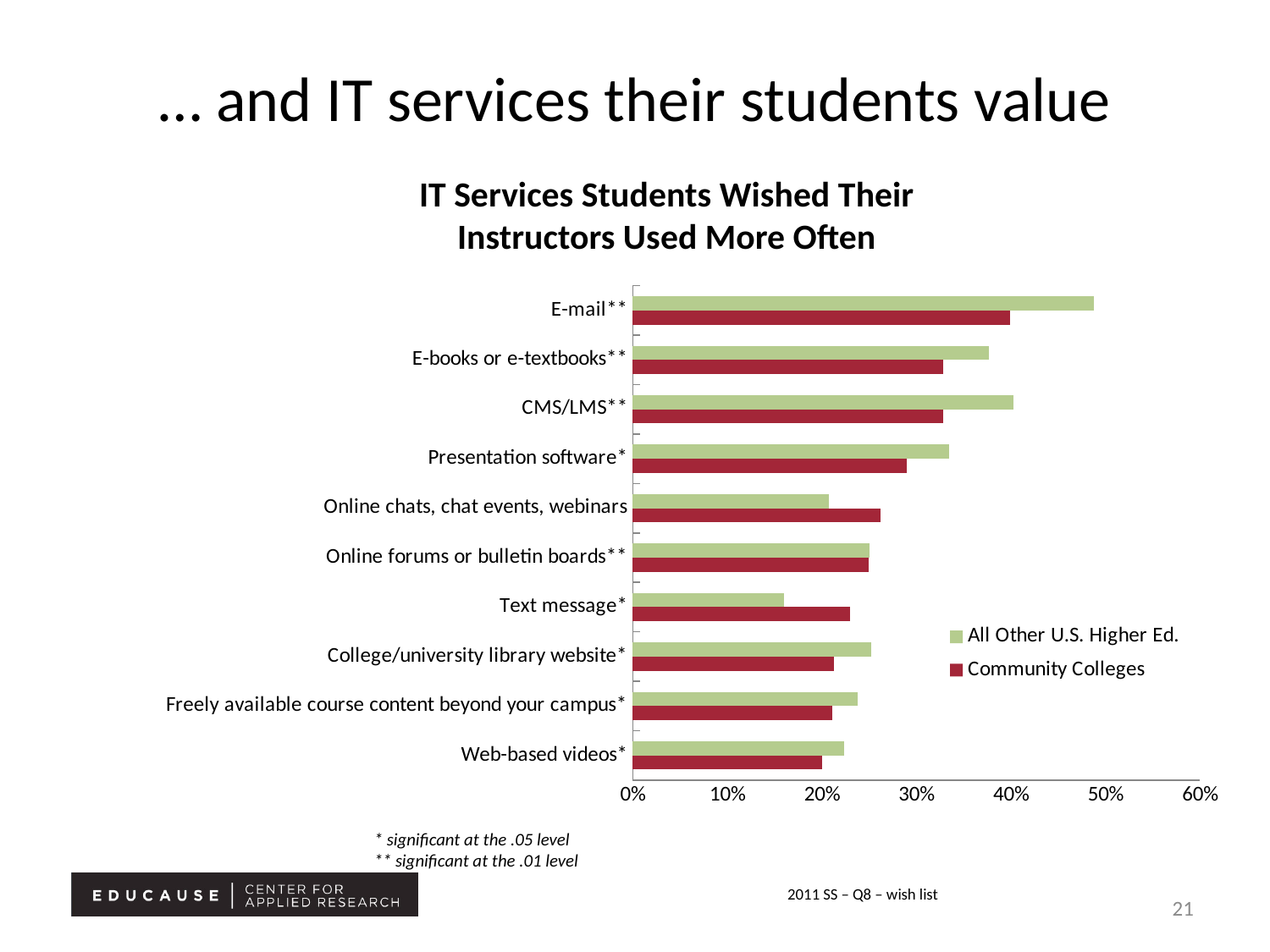
Is the All Other U.S. Higher Ed. value for E-mail** greater or less than 40%? greater Which category has the highest value for Community Colleges? E-mail** Which category has the lowest value for All Other U.S. Higher Ed.? Text message* Is the All Other U.S. Higher Ed. value for Text message* greater or less than 20%? less Is the Community Colleges value for Online chats, chat events, webinars greater or less than 20%? greater How many series does the legend list? 2 For CMS/LMS**, which series has the larger value: All Other U.S. Higher Ed. or Community Colleges? All Other U.S. Higher Ed. What kind of chart is shown on the slide? Bar chart What is the title of the chart? IT Services Students Wished Their Instructors Used More Often For Text message*, which series has the larger value: All Other U.S. Higher Ed. or Community Colleges? Community Colleges Which category has the highest value for All Other U.S. Higher Ed.? E-mail** How many IT service categories are plotted on the chart? 10